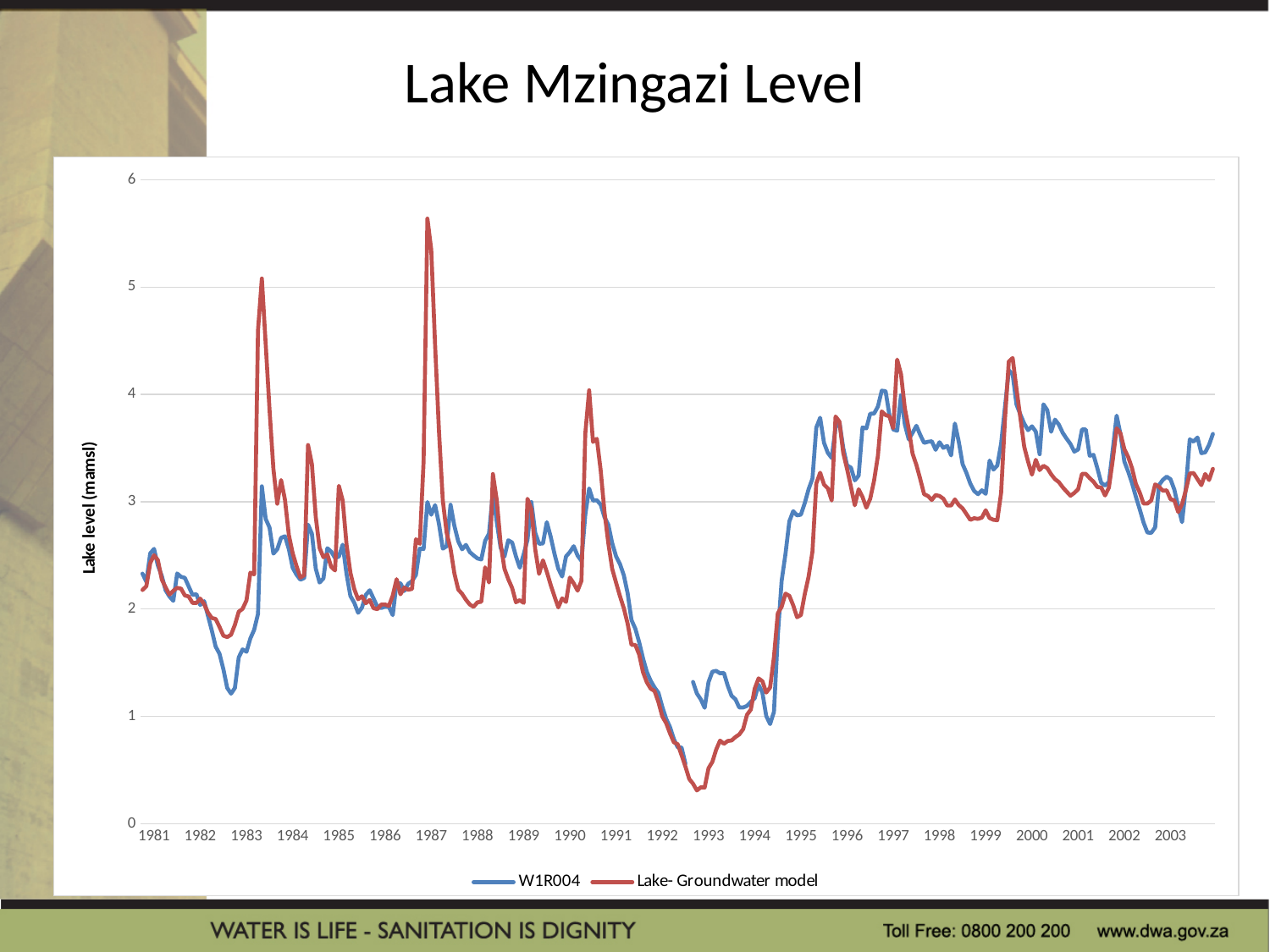
Is the highest peak of the Lake- Groundwater model line, around 1987, greater or less than 5? greater How many year labels are shown on the x axis? 23 What is the label on the vertical axis? Lake level (mamsl) Which series reaches a higher peak around 1983, W1R004 or Lake- Groundwater model? Lake- Groundwater model What are the two series named in the legend? W1R004 and Lake- Groundwater model Between 1991 and 1993, does the W1R004 line generally rise or fall? fall Is the lowest value of the Lake- Groundwater model line, around 1992-1993, greater or less than 1? less What kind of chart is shown on the slide? line chart Is the W1R004 value at its 1987 peak greater or less than 4? less Between 1994 and 1996, does the Lake- Groundwater model line generally rise or fall? rise How many series does the legend list? 2